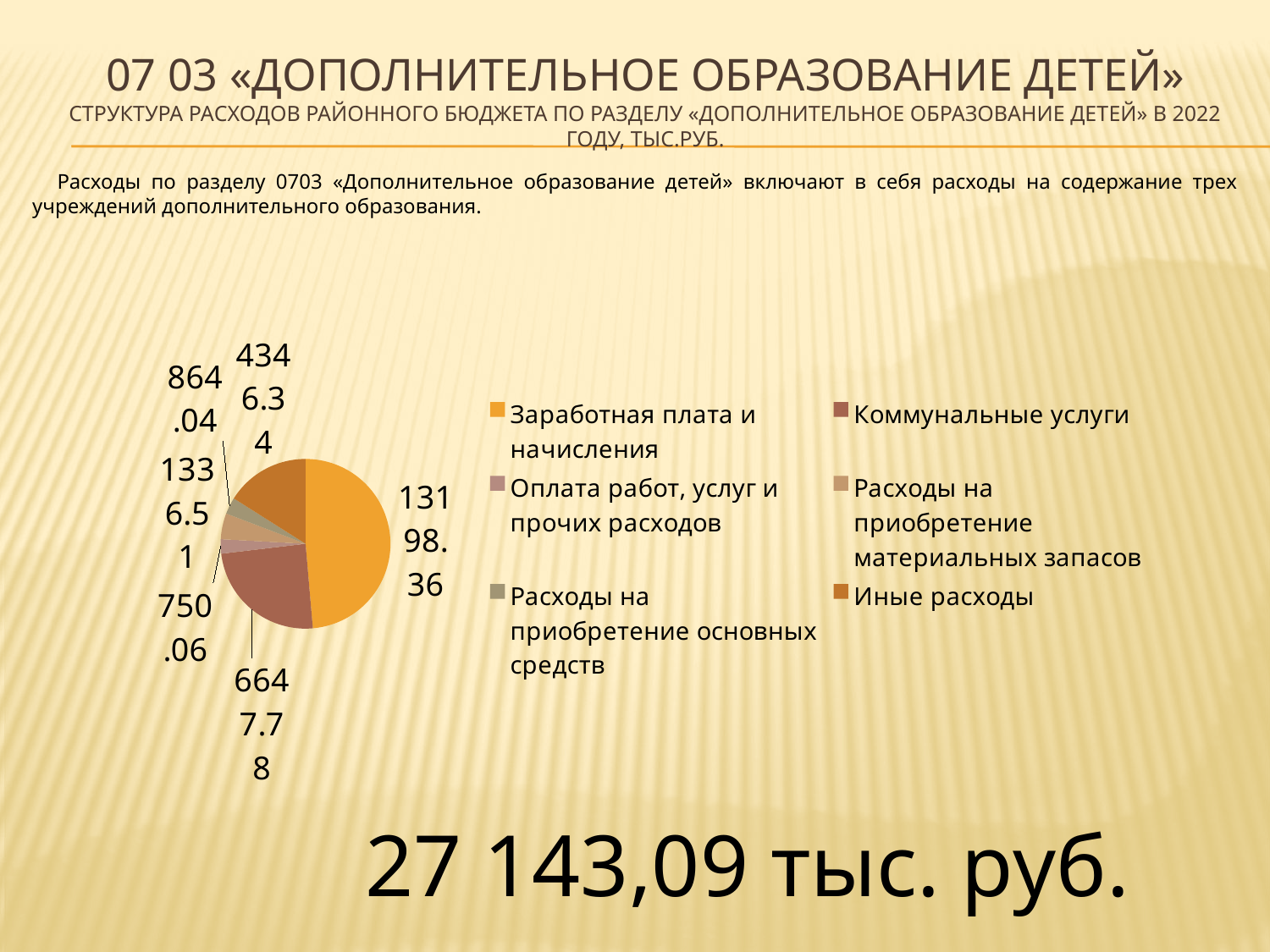
What total amount is printed below the pie chart? 27 143,09 тыс. руб. What kind of chart is shown on the slide? pie chart How many entries does the legend of the pie chart list? 6 Which category has the largest slice in the pie chart? Заработная плата и начисления Which is larger in the pie chart: «Коммунальные услуги» or «Иные расходы»? Коммунальные услуги What is the value for «Иные расходы» in the pie chart? 4346.34 What is the value for «Коммунальные услуги» in the pie chart? 6647.78 What is the value for «Оплата работ, услуг и прочих расходов» in the pie chart? 750.06 Which category has the smallest slice in the pie chart? Оплата работ, услуг и прочих расходов How many slices does the pie chart have? 6 What is the value for «Заработная плата и начисления» in the pie chart? 13198.36 What is the difference between the values for «Заработная плата и начисления» and «Коммунальные услуги»? 6550.58